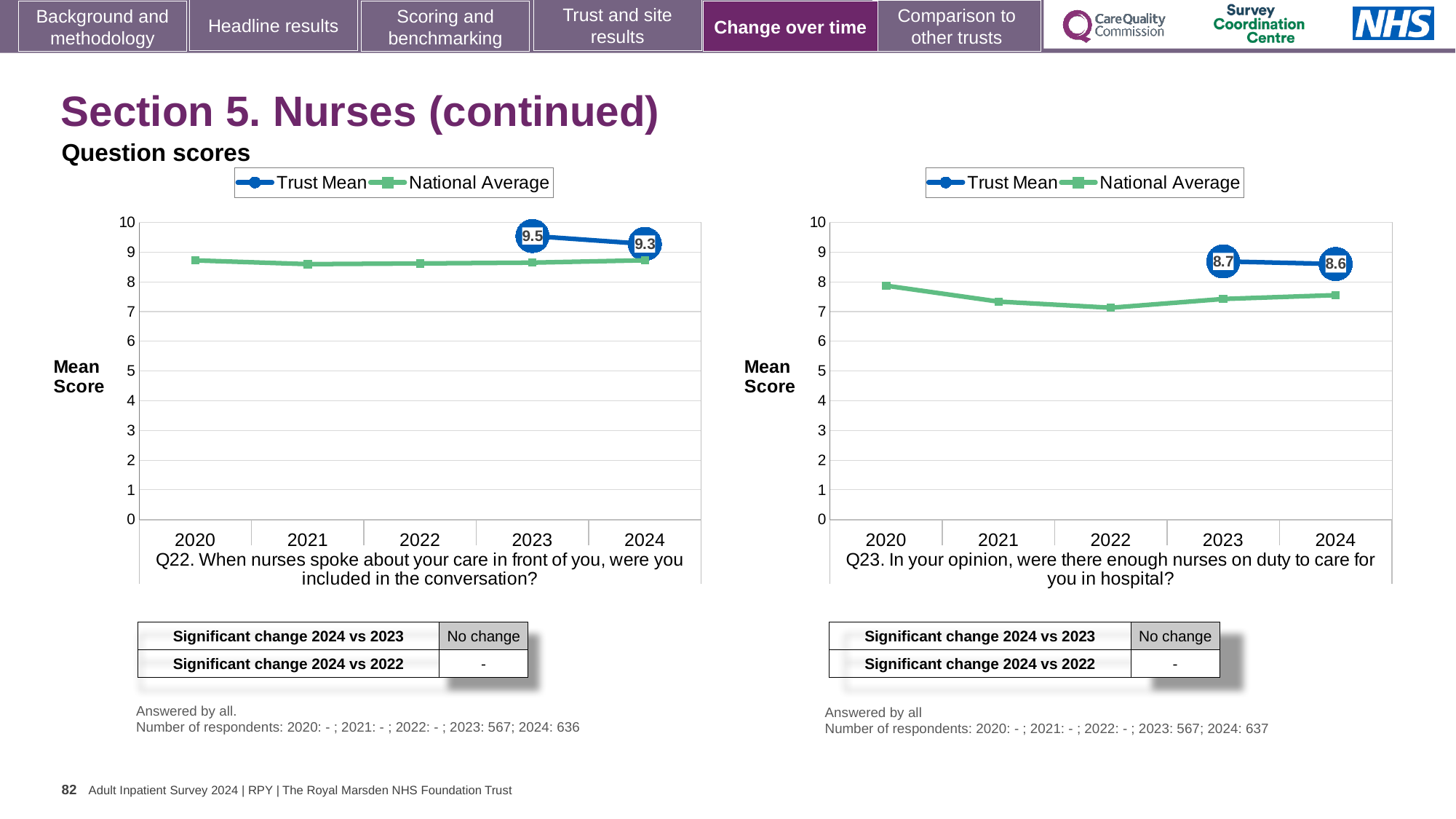
In the Q22 chart on the left, what is the Trust Mean score for 2024? 9.3 In the Q22 chart on the left, is the Trust Mean for 2024 higher or lower than the Trust Mean for 2023? lower How many series does the legend of the Q22 chart on the left list? 2 In the Q23 chart on the right, is the National Average for 2022 greater or less than 8? less In the Q22 chart on the left, is the National Average for 2020 greater or less than 8? greater In the Q22 chart on the left, by how much did the Trust Mean change from 2023 to 2024? 0.2 How many years are shown on the x axis of the Q23 chart on the right? 5 What type of chart is used for Q22 on the left? Line chart In the Q23 chart on the right, what is the Trust Mean score for 2023? 8.7 In the Q23 chart on the right, what is the Trust Mean score for 2024? 8.6 In the Q22 chart on the left, what is the Trust Mean score for 2023? 9.5 In the Q23 chart on the right, what is the difference between the Trust Mean in 2023 and 2024? 0.1